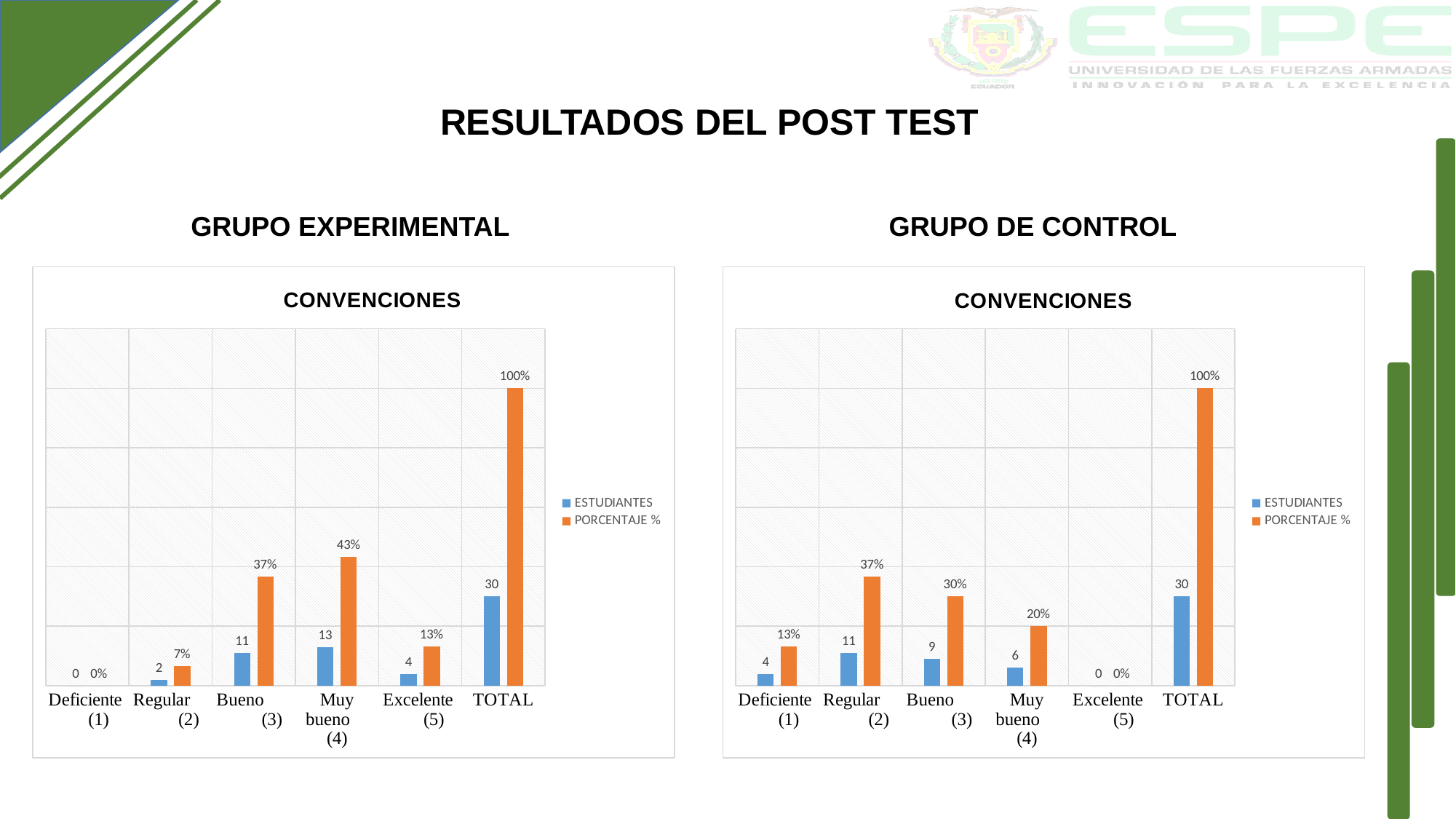
How many categories are shown on the x axis of the GRUPO DE CONTROL chart? 6 What type of chart is used for GRUPO DE CONTROL? Bar chart In the GRUPO DE CONTROL chart, what is the PORCENTAJE % for Regular (2)? 37% In the GRUPO EXPERIMENTAL chart, what is the difference in ESTUDIANTES between Muy bueno (4) and Bueno (3)? 2 In the GRUPO EXPERIMENTAL chart, what is the PORCENTAJE % for Bueno (3)? 37% In the GRUPO EXPERIMENTAL chart, excluding TOTAL, which category has the highest number of ESTUDIANTES? Muy bueno (4) Which chart shows more ESTUDIANTES in the Excelente (5) category, GRUPO EXPERIMENTAL or GRUPO DE CONTROL? GRUPO EXPERIMENTAL In the GRUPO DE CONTROL chart, how many ESTUDIANTES are in the Deficiente (1) category? 4 In the GRUPO EXPERIMENTAL chart, how many ESTUDIANTES are in the Muy bueno (4) category? 13 In the GRUPO DE CONTROL chart, which category has the lowest number of ESTUDIANTES? Excelente (5) How many series does the legend of the GRUPO EXPERIMENTAL chart list? 2 In the GRUPO DE CONTROL chart, what is the difference in PORCENTAJE % between Regular (2) and Muy bueno (4)? 17%